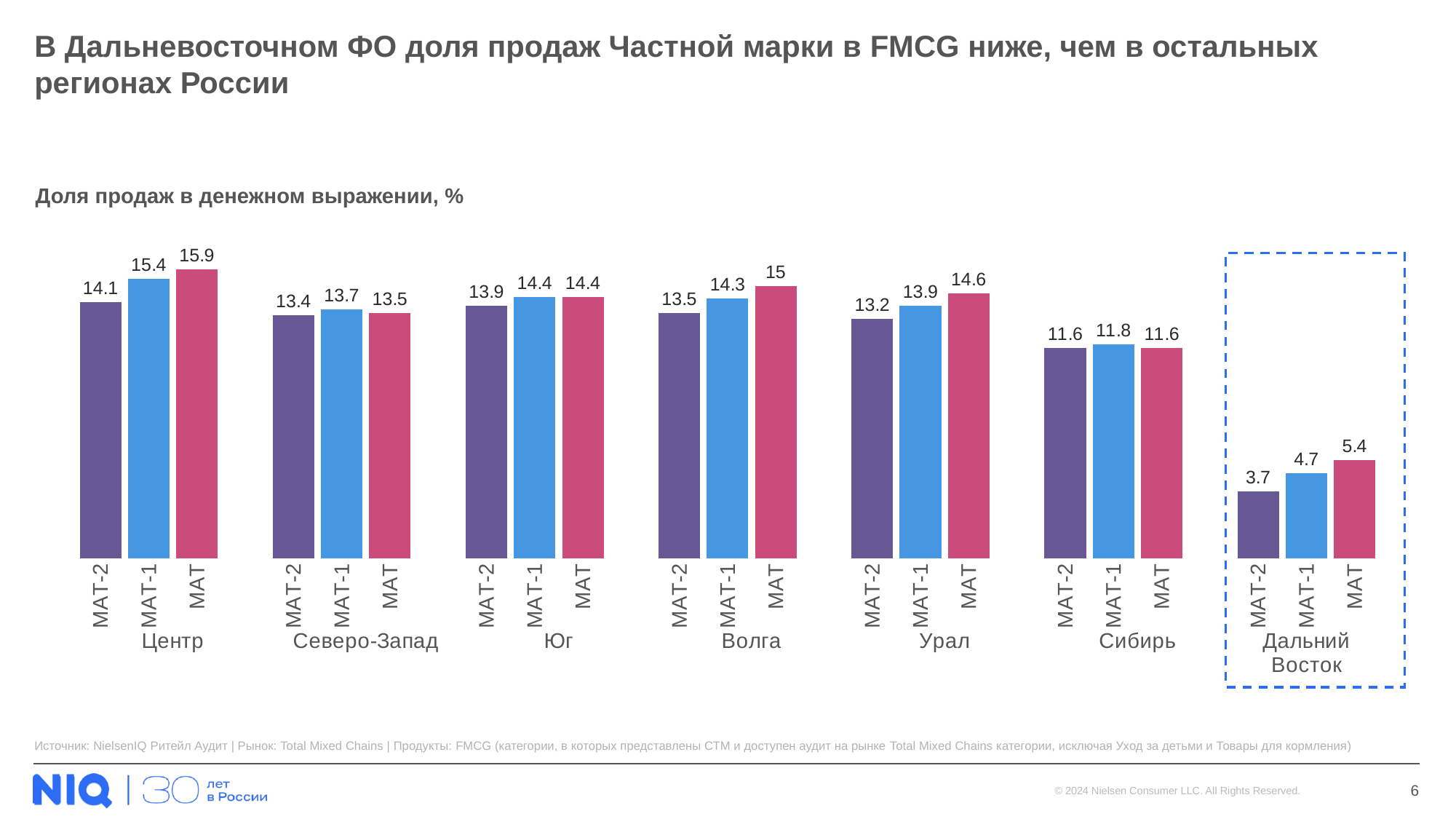
What is the value for MAT-1 in the Урал region? 13.9 Which region has the lowest MAT-2 value? Дальний Восток What is the value for MAT in the Центр region? 15.9 What is the difference between MAT and MAT-2 in the Волга region? 1.5 How many regions are shown on the chart? 7 What is the value for MAT-2 in the Дальний Восток region? 3.7 Which is larger: the MAT value for Урал or the MAT value for Сибирь? Урал Do the values for Дальний Восток rise or fall from MAT-2 to MAT? Rise What kind of chart is shown on the slide? Bar chart Which region is highlighted with a dashed blue box on the chart? Дальний Восток Which region has the highest MAT value? Центр What is the difference between the MAT value for Центр and the MAT value for Дальний Восток? 10.5